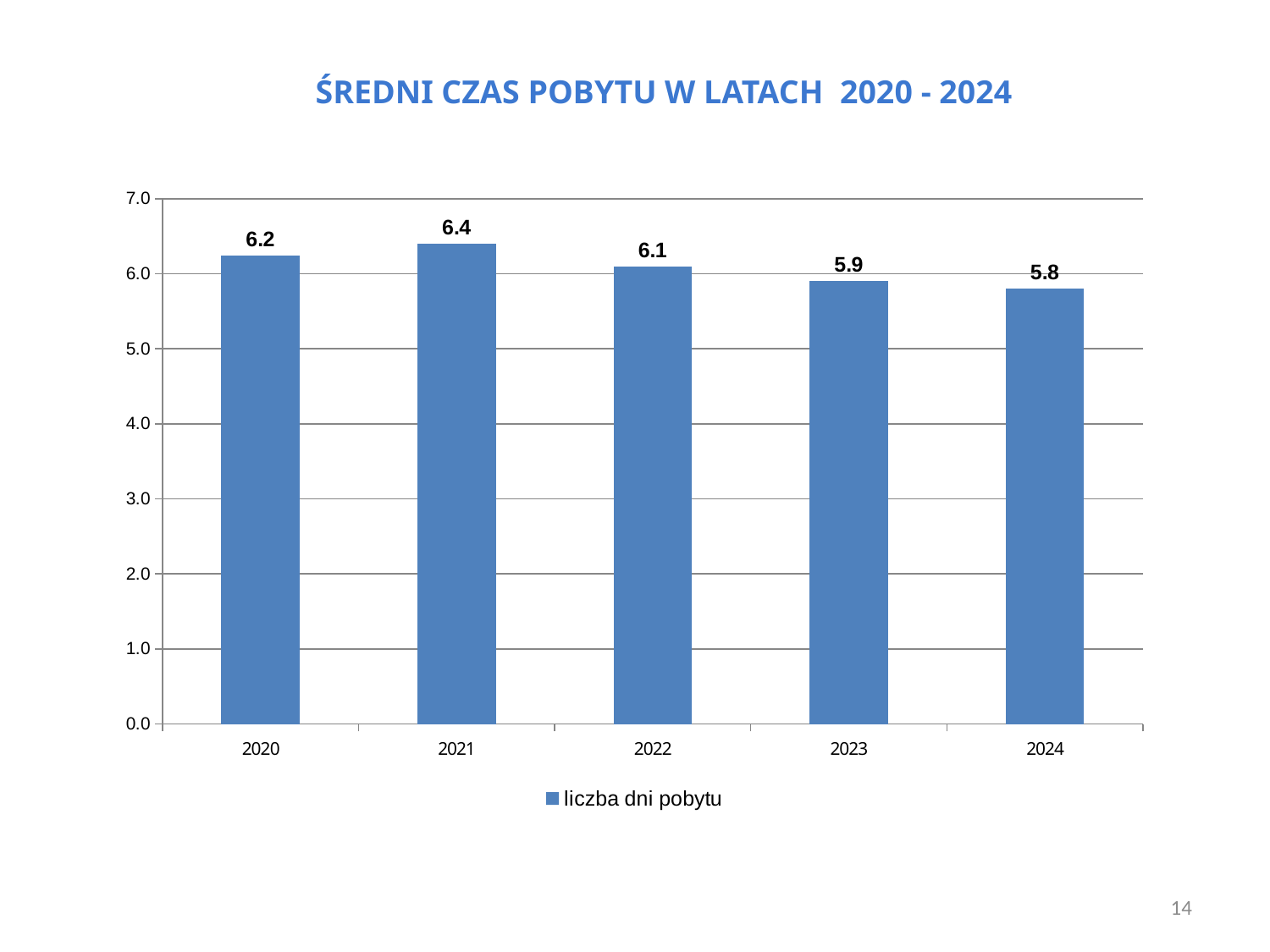
What is the value for 2020? 6.2 Which is larger, the value for 2020 or the value for 2023? 2020 How many years are shown on the x axis? 5 Is the value for 2023 greater or less than 5.0? greater Which year has the highest value? 2021 What is the value for 2022? 6.1 What is the difference between the values for 2021 and 2024? 0.6 What is the value for 2024? 5.8 How many series does the legend list? 1 Which year has the lowest value? 2024 What kind of chart is shown? bar chart Do the values rise or fall from 2021 to 2024? fall